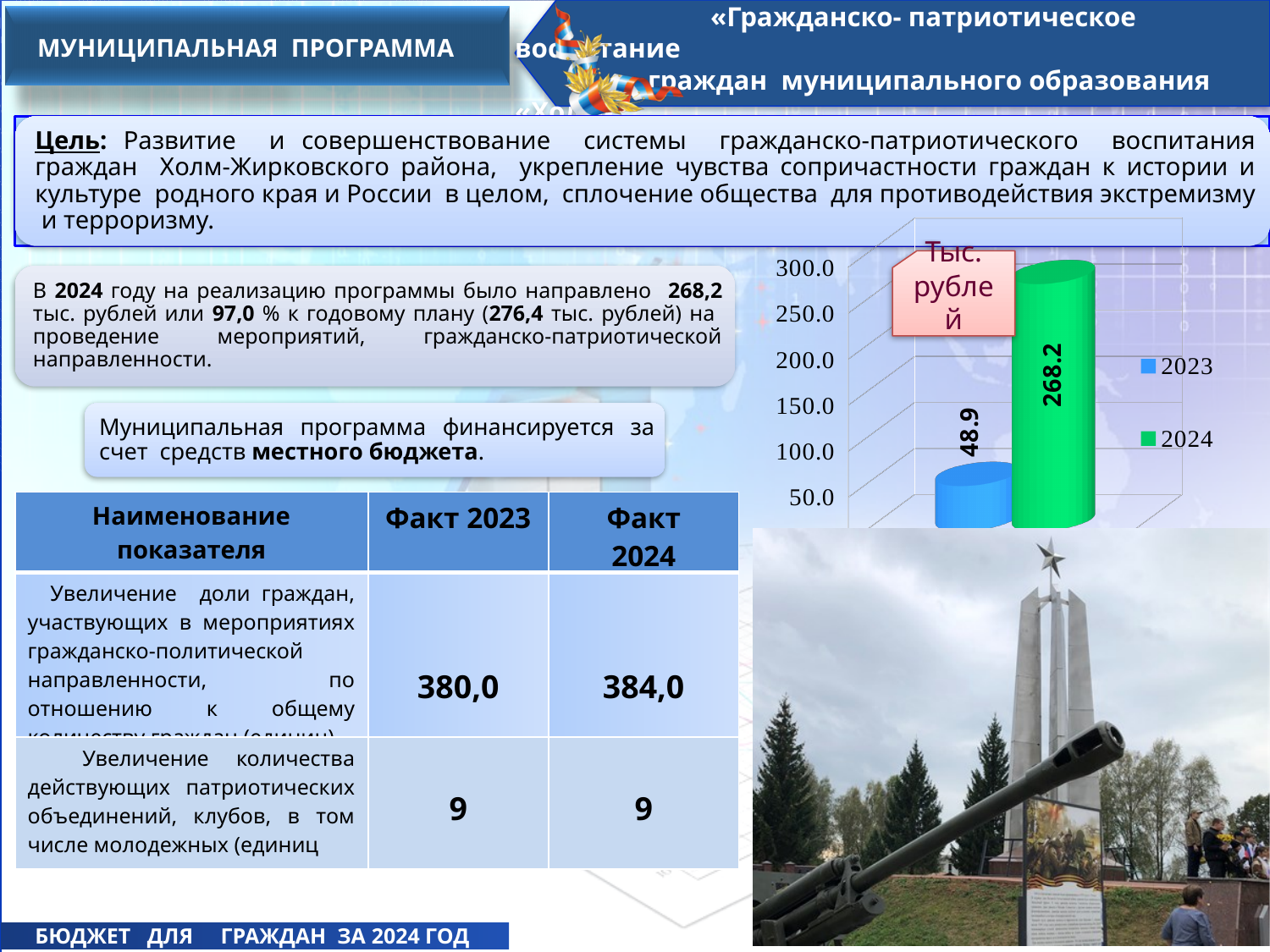
Which year has the lowest value on the chart? 2023 What unit label is shown on the chart? Тыс. рублей What is the value shown for 2024 on the chart? 268.2 What is the value shown for 2023 on the chart? 48.9 Is the value for 2024 on the chart greater or less than 250.0? greater Which year has the higher value on the chart, 2023 or 2024? 2024 What is the difference between the 2024 value and the 2023 value on the chart? 219.3 What kind of chart is shown on the slide? bar chart What colour is the bar for 2024 on the chart? green How many series does the chart legend list? 2 Is the value for 2023 on the chart greater or less than 100.0? less Which year has the highest value on the chart? 2024